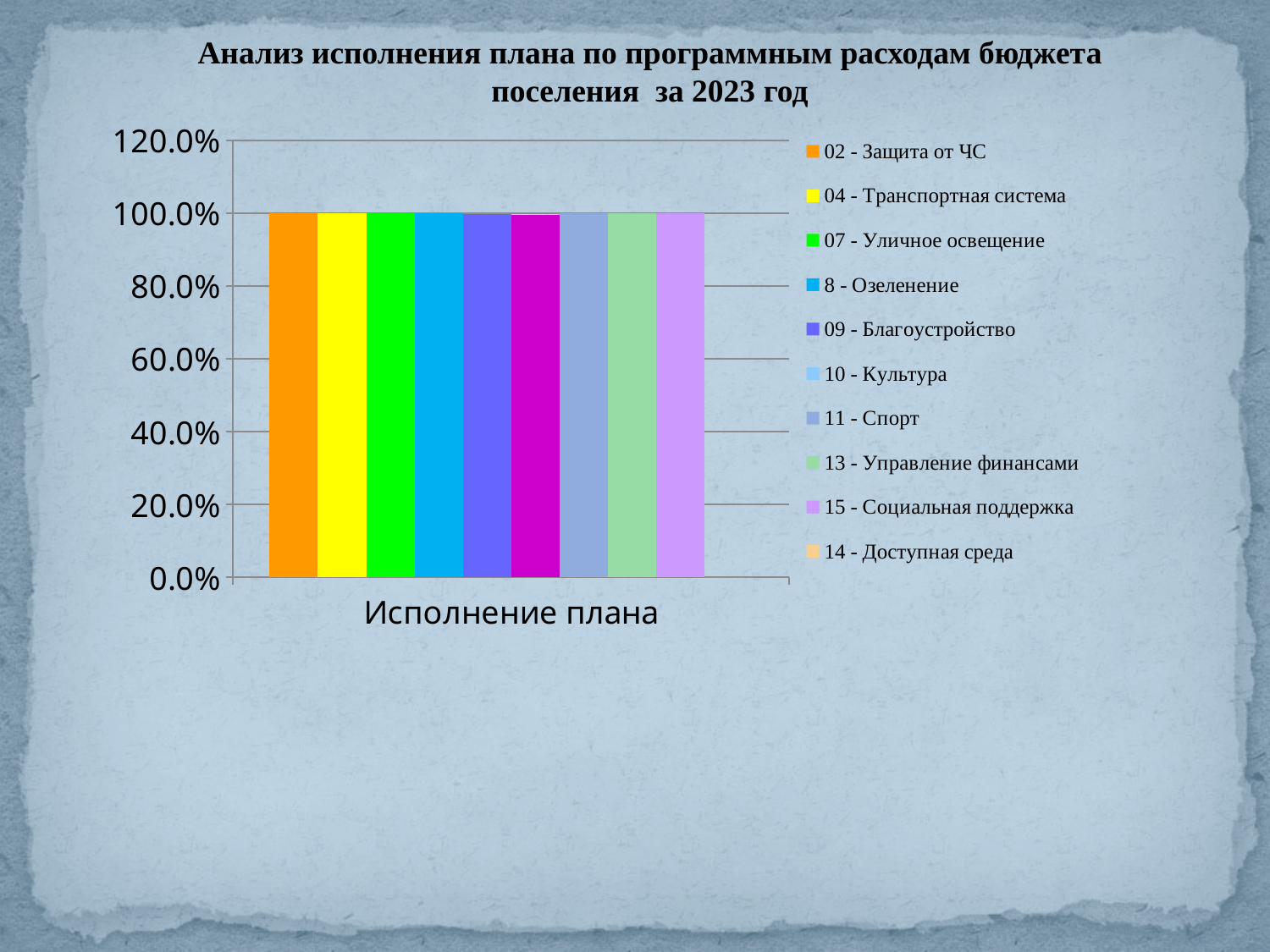
Is the value for 07 - Уличное освещение greater or less than 80.0%? greater What kind of chart is shown on the slide? bar chart Is the value for 10 - Культура greater or less than 120.0%? less What is the category label shown on the x axis? Исполнение плана How many bars are plotted in the chart? 9 What is the title of the chart? Анализ исполнения плана по программным расходам бюджета поселения за 2023 год Is the value for 09 - Благоустройство greater or less than 40.0%? greater What value does the bar for 04 - Транспортная система reach on the y axis? 100.0% How many series does the legend list? 10